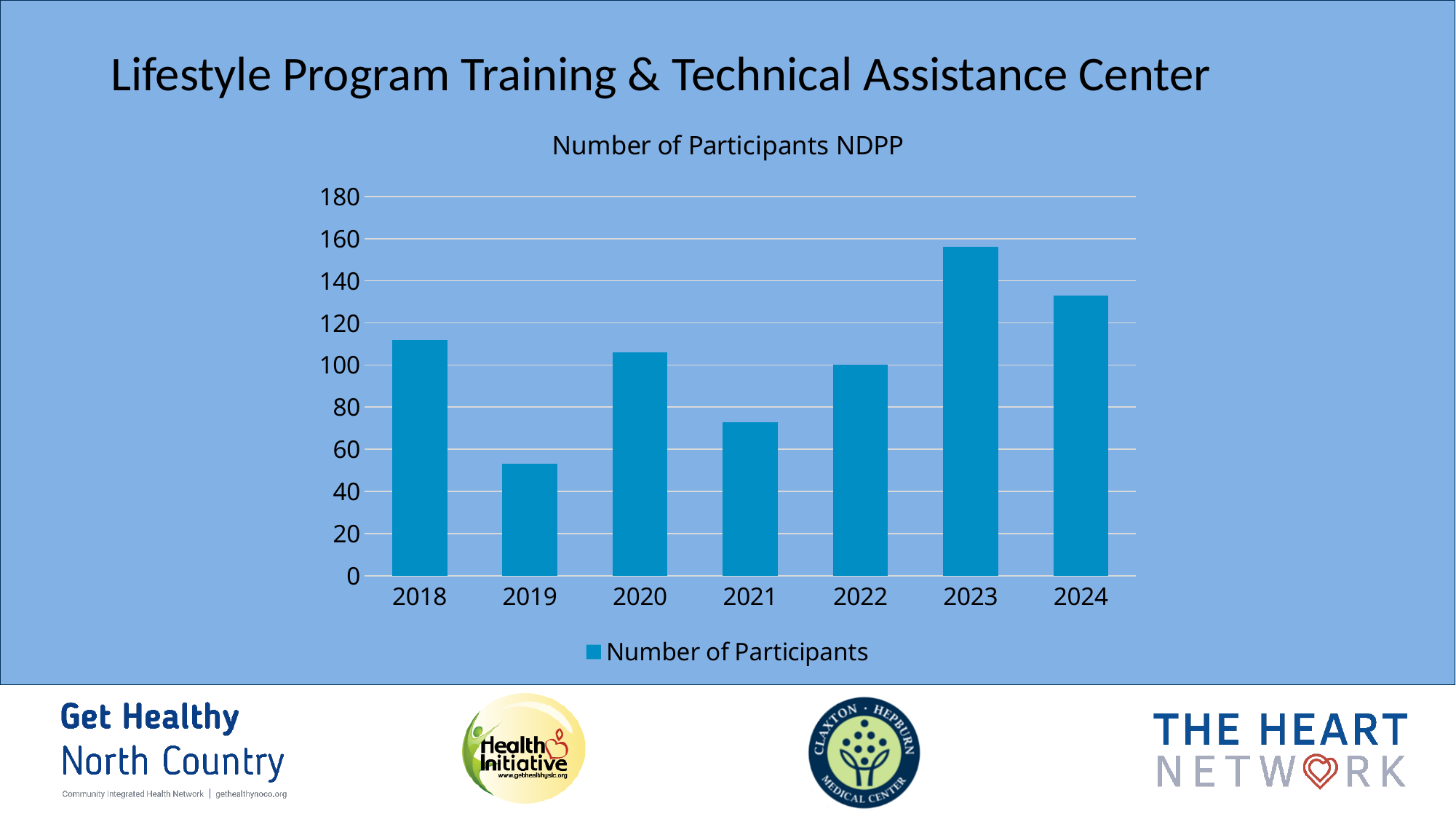
Is the value for 2024 greater or less than 120? greater What is the legend entry for the series in the chart? Number of Participants How many series does the legend list? 1 Which year has more participants, 2024 or 2021? 2024 What kind of chart is shown on the slide? bar chart Which year has the lowest number of participants? 2019 Is the value for 2023 greater or less than 140? greater How many years are shown on the x axis of the chart? 7 Is the value for 2019 greater or less than 60? less What is the title of the chart? Number of Participants NDPP Which year has more participants, 2019 or 2021? 2021 Which year has the highest number of participants? 2023